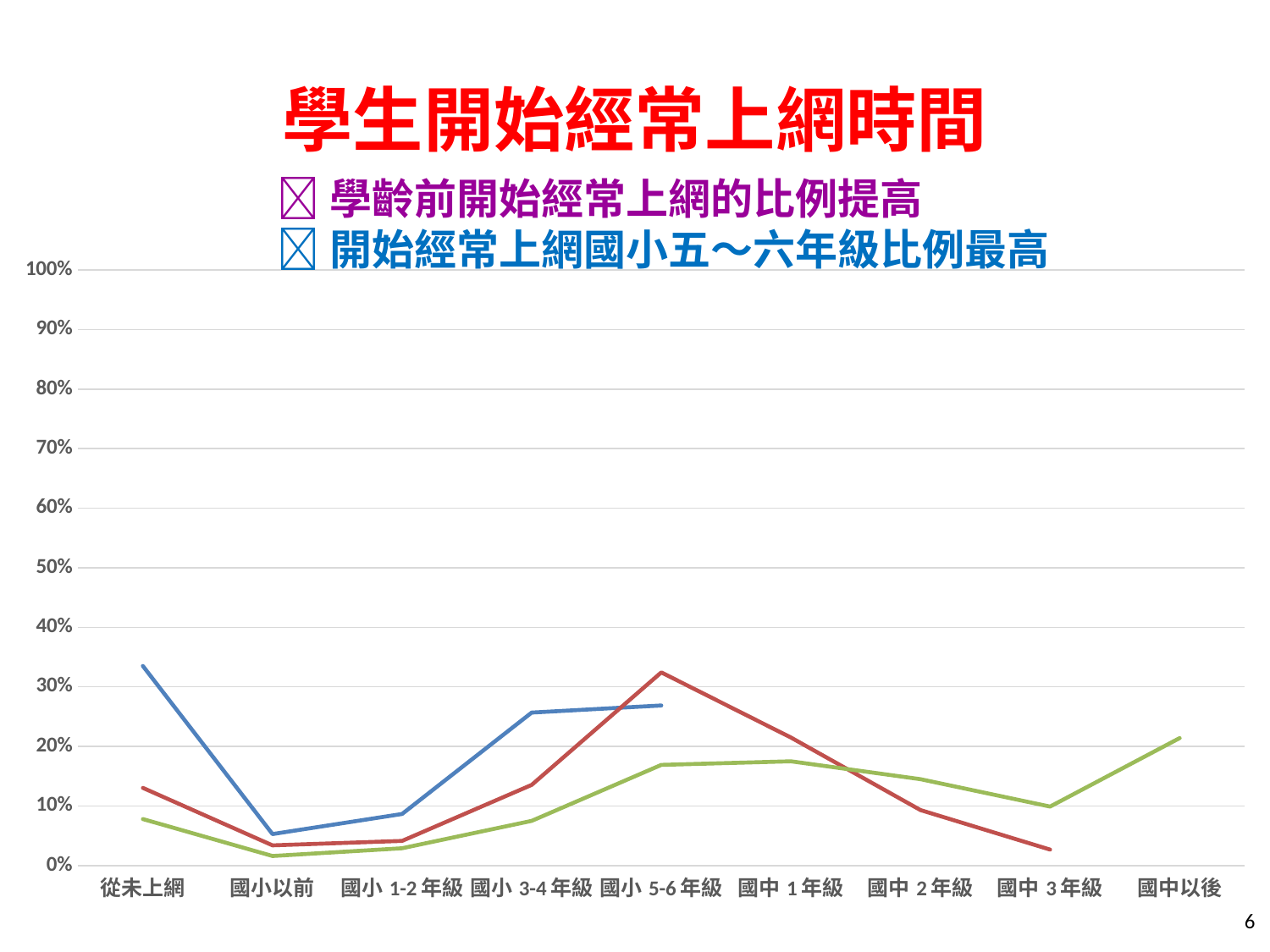
Does the green line rise or fall from 國中 1 年級 to 國中 3 年級? fall What kind of chart is shown on the slide? line chart How many categories are shown along the x axis of the chart? 9 What is the title of the slide's chart? 學生開始經常上網時間 Is the value of the red line at 國小 5-6 年級 greater or less than 25%? greater Is the value of the blue line at 從未上網 greater or less than 30%? greater At 國小 5-6 年級, which line has the higher value, the red line or the blue line? the red line Is the value of the red line at 國中 3 年級 greater or less than 5%? less At which category does the red line reach its highest value? 國小 5-6 年級 At which category does the blue line reach its highest value? 從未上網 At which category does the green line reach its lowest value? 國小以前 Which coloured line is the only one that extends to the 國中以後 category? the green line